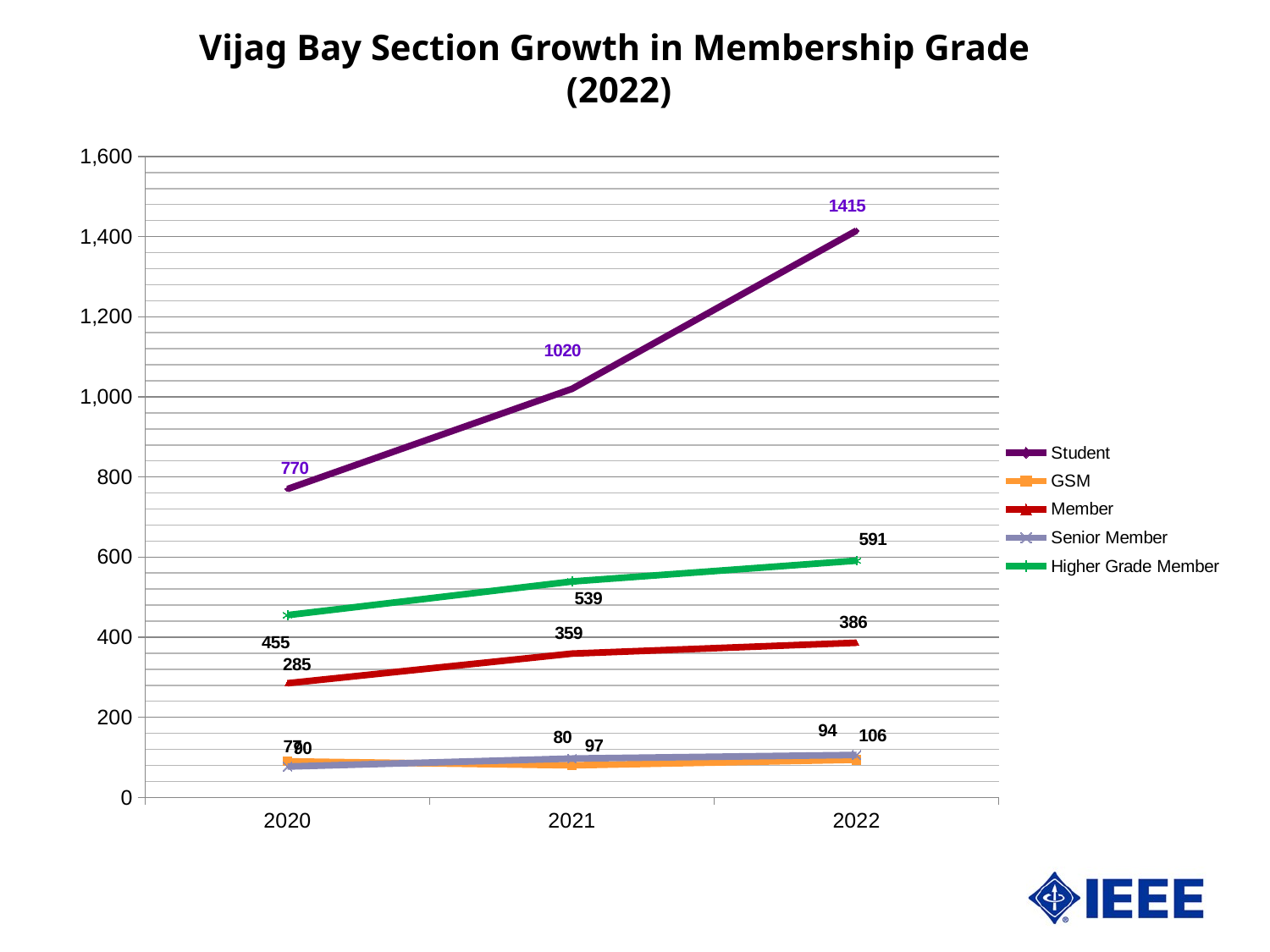
By how much did the Student value increase from 2020 to 2022? 645 Does the Student series rise or fall from 2020 to 2022? rise What is the Student value for 2022? 1415 What is the difference between the Higher Grade Member values for 2022 and 2021? 52 What type of chart is shown on the slide? line chart Which series has the highest value in 2022? Student Which is larger in 2022, Member or Higher Grade Member? Higher Grade Member What is the Higher Grade Member value for 2022? 591 How many years are plotted along the x axis? 3 What is the Member value for 2021? 359 How many series does the legend list? 5 What is the Student value for 2020? 770